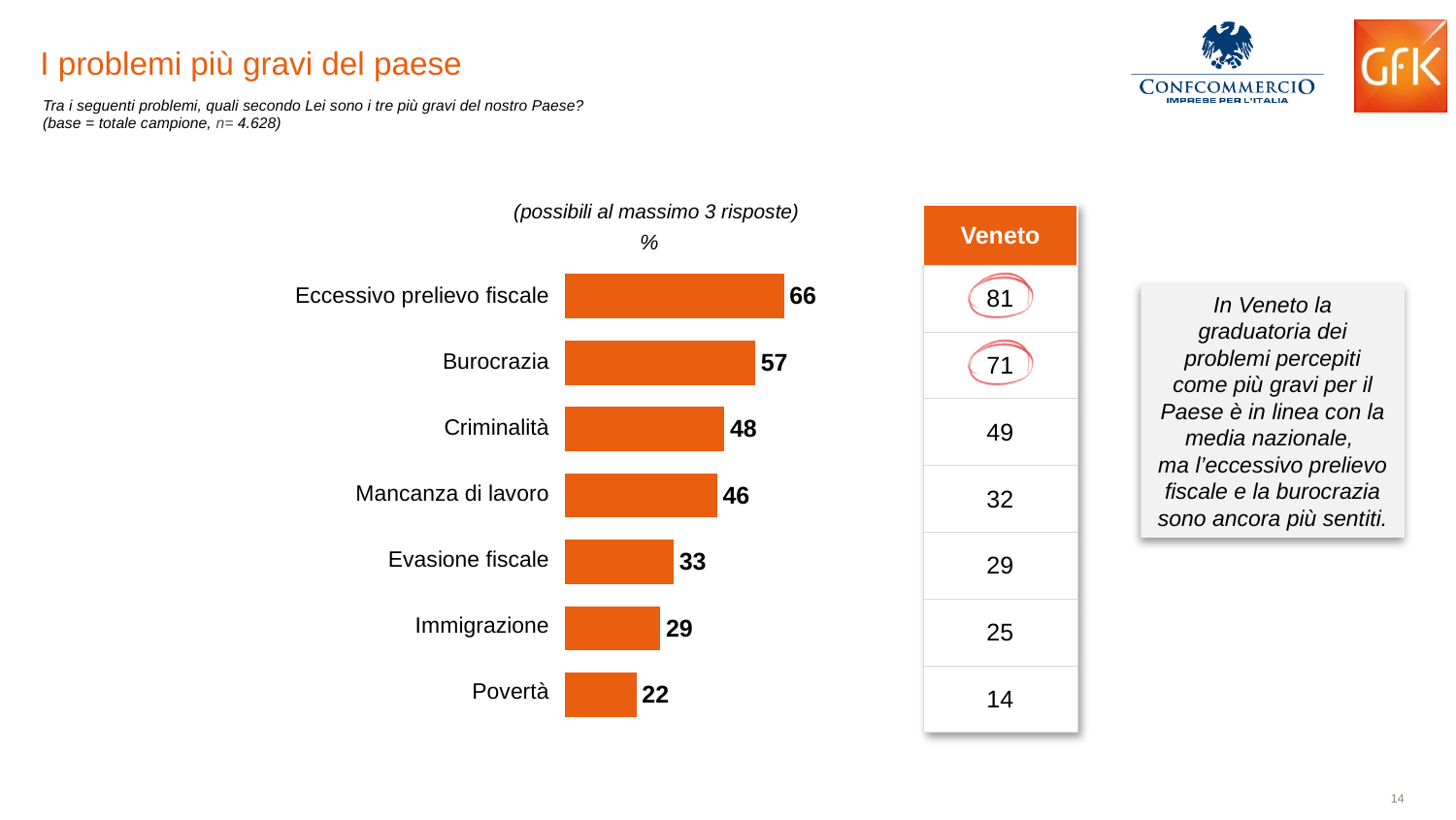
What is the value for Povertà in the bar chart? 22 What kind of chart is shown on the slide? Bar chart What is the value for Mancanza di lavoro in the bar chart? 46 Which category has the lowest value in the bar chart? Povertà What is the Veneto value shown next to Eccessivo prelievo fiscale in the table beside the chart? 81 How many categories are shown in the bar chart? 7 Which is larger in the bar chart, the value for Evasione fiscale or the value for Immigrazione? Evasione fiscale Do the values in the bar chart rise or fall from top to bottom? Fall What is the difference between the values for Criminalità and Immigrazione in the bar chart? 19 What is the difference between the values for Eccessivo prelievo fiscale and Burocrazia in the bar chart? 9 Which category has the highest value in the bar chart? Eccessivo prelievo fiscale What is the value for Burocrazia in the bar chart? 57